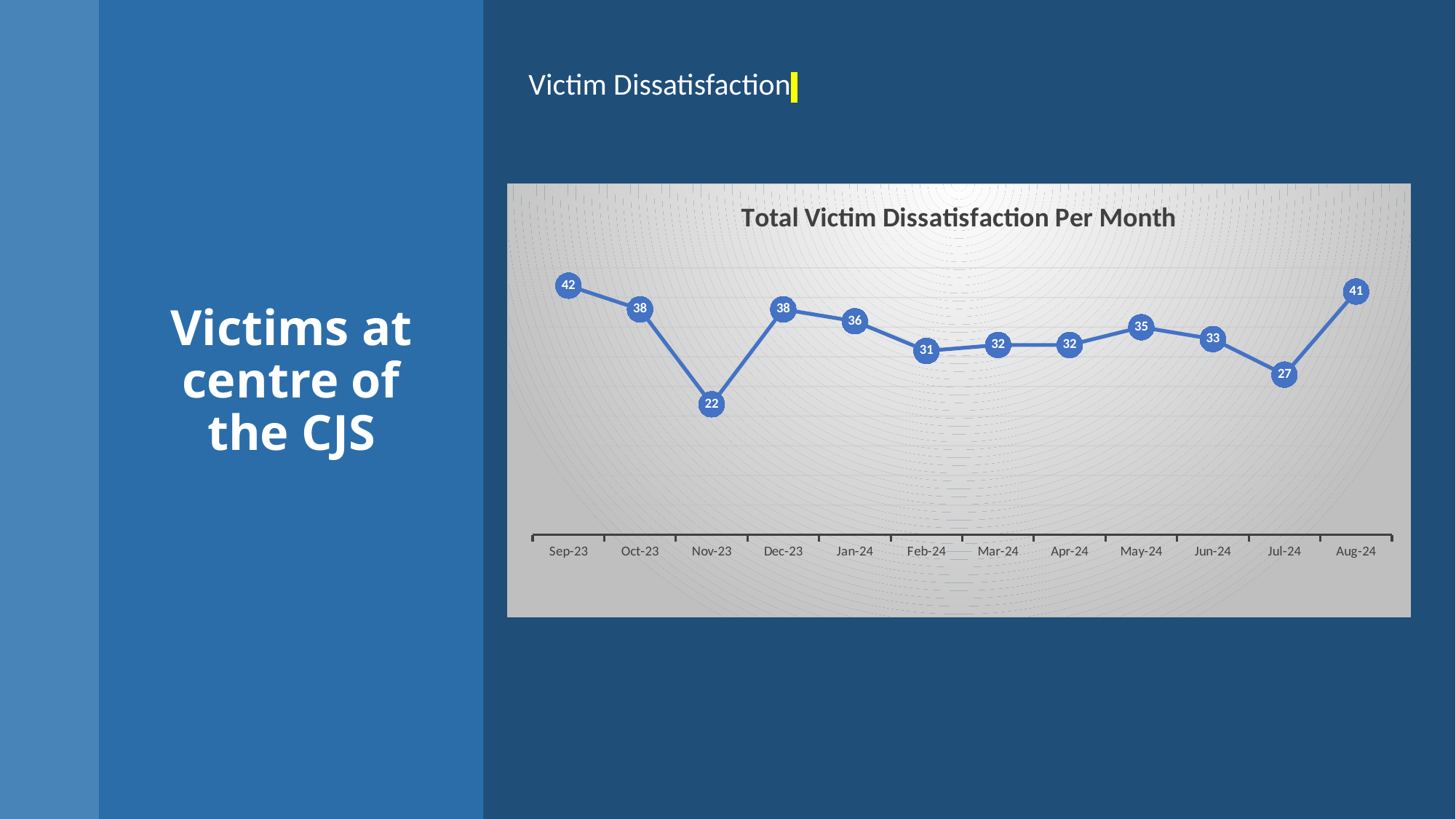
What is the difference between the values for Aug-24 and Jul-24? 14 Which is larger, the value for Dec-23 or the value for Feb-24? Dec-23 What is the value for Aug-24? 41 Which month has the lowest value? Nov-23 What is the title of the chart? Total Victim Dissatisfaction Per Month What is the value for Nov-23? 22 What is the value for Sep-23? 42 What is the value for Jul-24? 27 Which month has the highest value? Sep-23 What kind of chart is shown? Line chart What is the difference between the values for Sep-23 and Nov-23? 20 How many months are plotted on the chart? 12